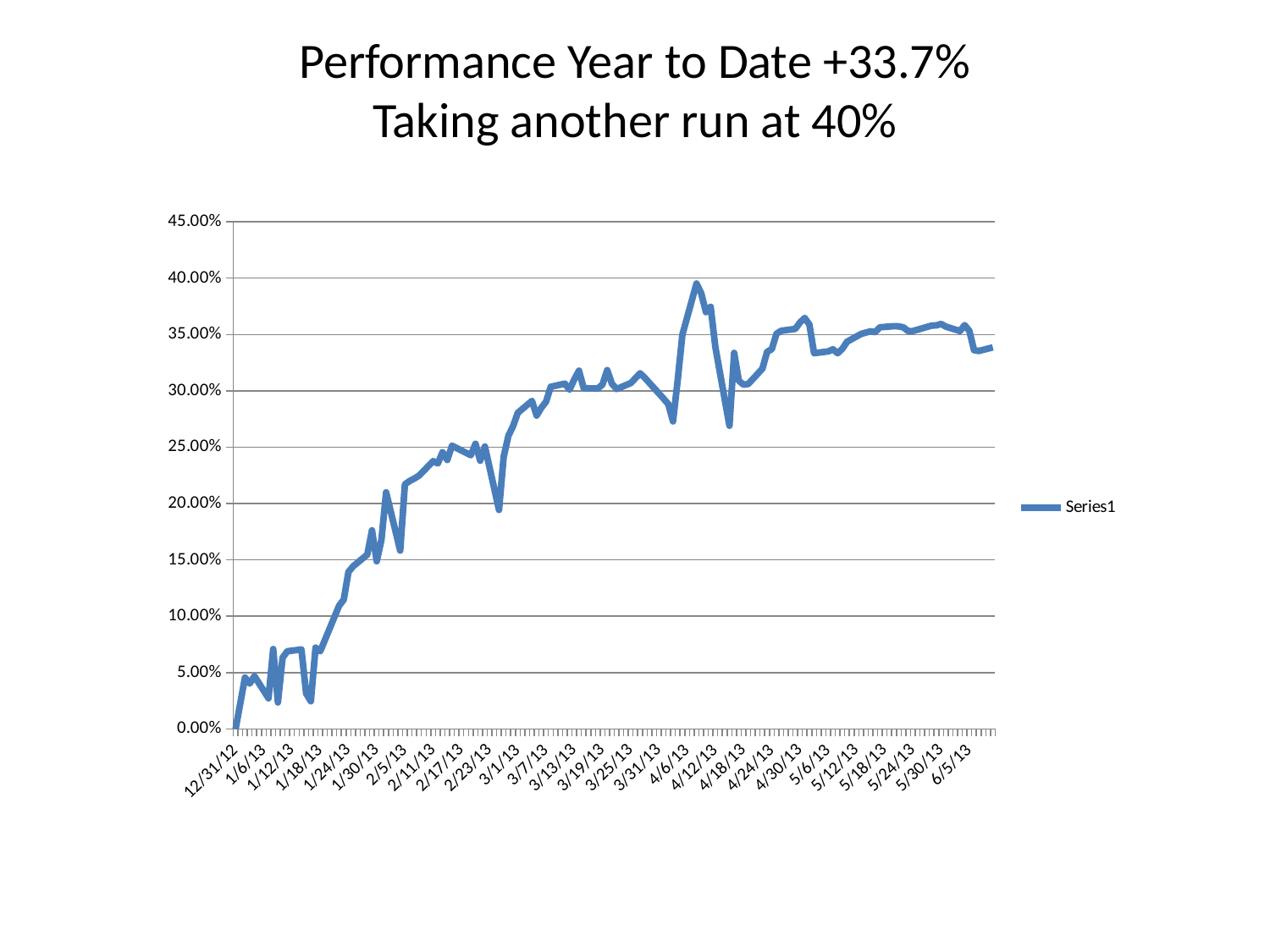
Overall, does the line rise or fall from 12/31/12 to 6/5/13? rise Is the value for 1/6/13 greater or less than 10%? less Is the value for 2/11/13 greater or less than 20%? greater Around which x-axis date does the line reach its highest point? 4/6/13 What is the name of the series shown in the legend? Series1 Is the value for 3/13/13 greater or less than 25%? greater What is the value of the line at 12/31/12? 0.00% How many series does the legend list? 1 What is the title of the chart's slide? Performance Year to Date +33.7% Taking another run at 40% What kind of chart is shown on the slide? line chart